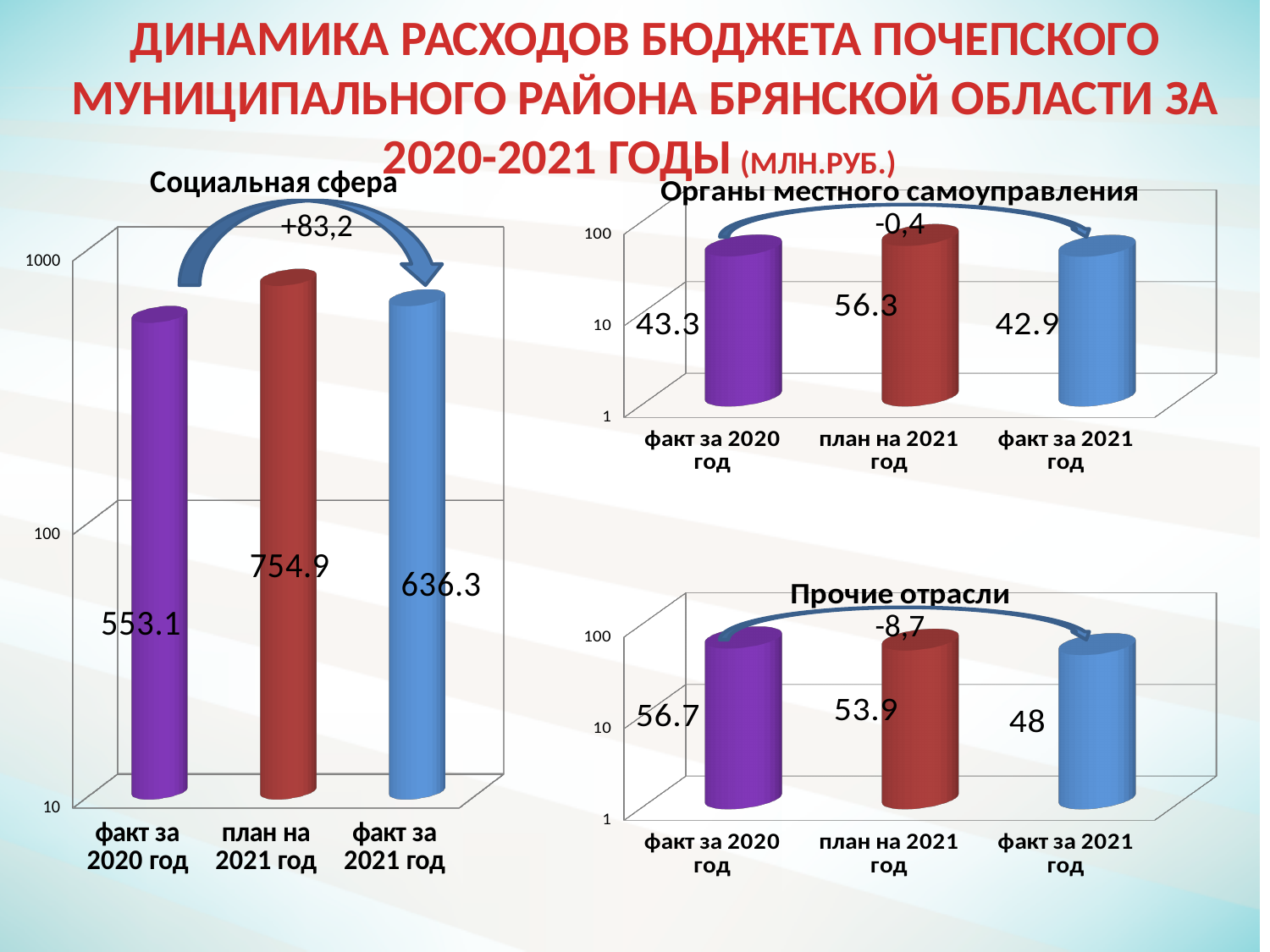
In the chart titled "Прочие отрасли", what is the difference between the values for "факт за 2020 год" and "факт за 2021 год"? 8.7 In the chart titled "Прочие отрасли", what is the value for "план на 2021 год"? 53.9 In the chart titled "Социальная сфера", what is the value for "факт за 2020 год"? 553.1 In the chart titled "Органы местного самоуправления", what is the value for "факт за 2021 год"? 42.9 What kind of chart is the chart titled "Социальная сфера"? bar chart In the chart titled "Социальная сфера", what is the difference between the values for "факт за 2021 год" and "факт за 2020 год"? 83.2 In the chart titled "Прочие отрасли", which category has the lowest value? факт за 2021 год In the chart titled "Органы местного самоуправления", which is larger: the value for "план на 2021 год" or the value for "факт за 2020 год"? план на 2021 год In the chart titled "Социальная сфера", which category has the highest value? план на 2021 год How many categories are shown in the chart titled "Прочие отрасли"? 3 In the chart titled "Прочие отрасли", do the values rise or fall from left to right along the x axis? fall In the chart titled "Социальная сфера", what is the value for "план на 2021 год"? 754.9